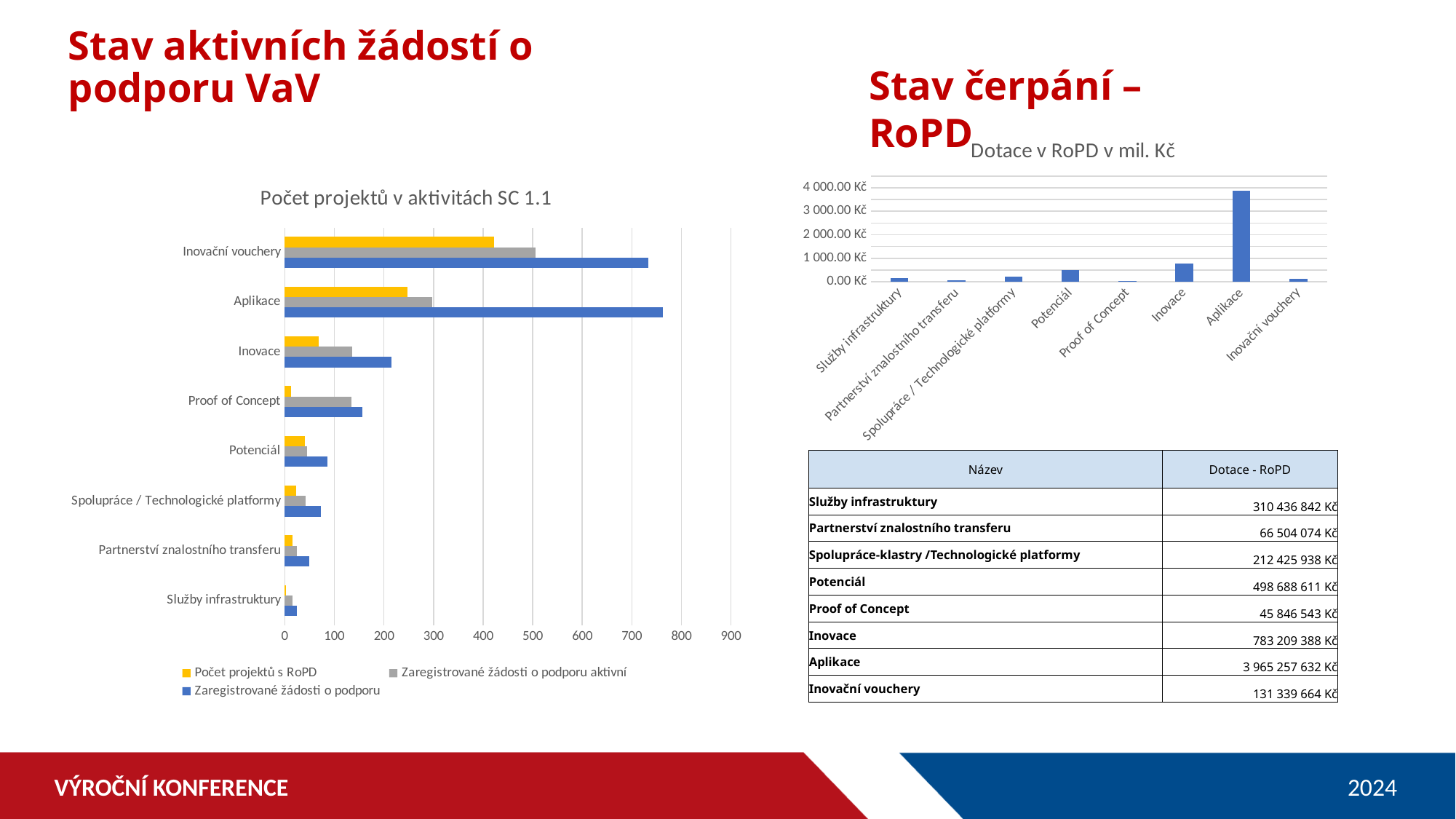
On the chart titled "Dotace v RoPD v mil. Kč", which category has the highest value? Aplikace On the chart titled "Počet projektů v aktivitách SC 1.1", how many categories are shown on the vertical axis? 8 On the chart titled "Dotace v RoPD v mil. Kč", how many categories are shown on the x axis? 8 On the chart titled "Počet projektů v aktivitách SC 1.1", is the value of Počet projektů s RoPD for Inovační vouchery greater or less than 400? greater On the chart titled "Počet projektů v aktivitách SC 1.1", which is larger for Inovace: Počet projektů s RoPD or Zaregistrované žádosti o podporu? Zaregistrované žádosti o podporu On the chart titled "Dotace v RoPD v mil. Kč", is the value for Aplikace greater or less than 3 000.00 Kč? greater On the chart titled "Počet projektů v aktivitách SC 1.1", how many series does the legend list? 3 On the chart titled "Počet projektů v aktivitách SC 1.1", which category has the highest value for Počet projektů s RoPD? Inovační vouchery On the chart titled "Počet projektů v aktivitách SC 1.1", which category has the lowest value for Zaregistrované žádosti o podporu? Služby infrastruktury What kind of chart is the chart titled "Dotace v RoPD v mil. Kč"? bar chart On the chart titled "Počet projektů v aktivitách SC 1.1", is the value of Zaregistrované žádosti o podporu for Aplikace greater or less than 700? greater